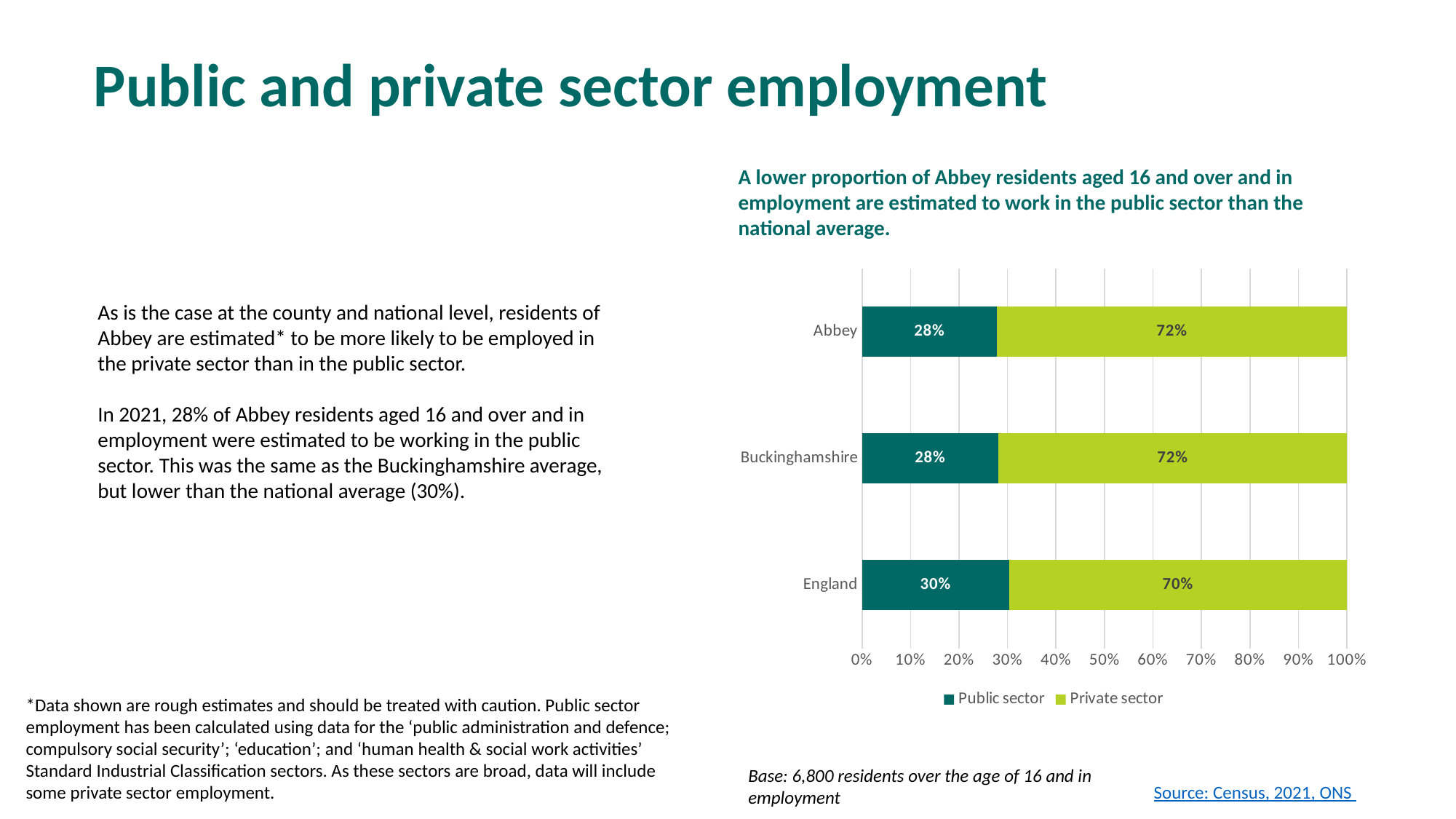
What kind of chart is shown on the slide? Stacked bar chart What is the total of the stacked bar for Buckinghamshire? 100% What percentage of Abbey residents in employment work in the public sector? 28% What is the public sector value for Buckinghamshire? 28% Which colour represents the public sector in the chart? Dark teal What is the difference between the public sector values for England and Abbey? 2% How many series does the legend list? 2 Which area has the highest public sector share? England How many areas are shown on the chart? 3 What is the private sector value for England? 70% Is the private sector value for Abbey larger or smaller than the private sector value for England? larger Which area has the lowest private sector share? England